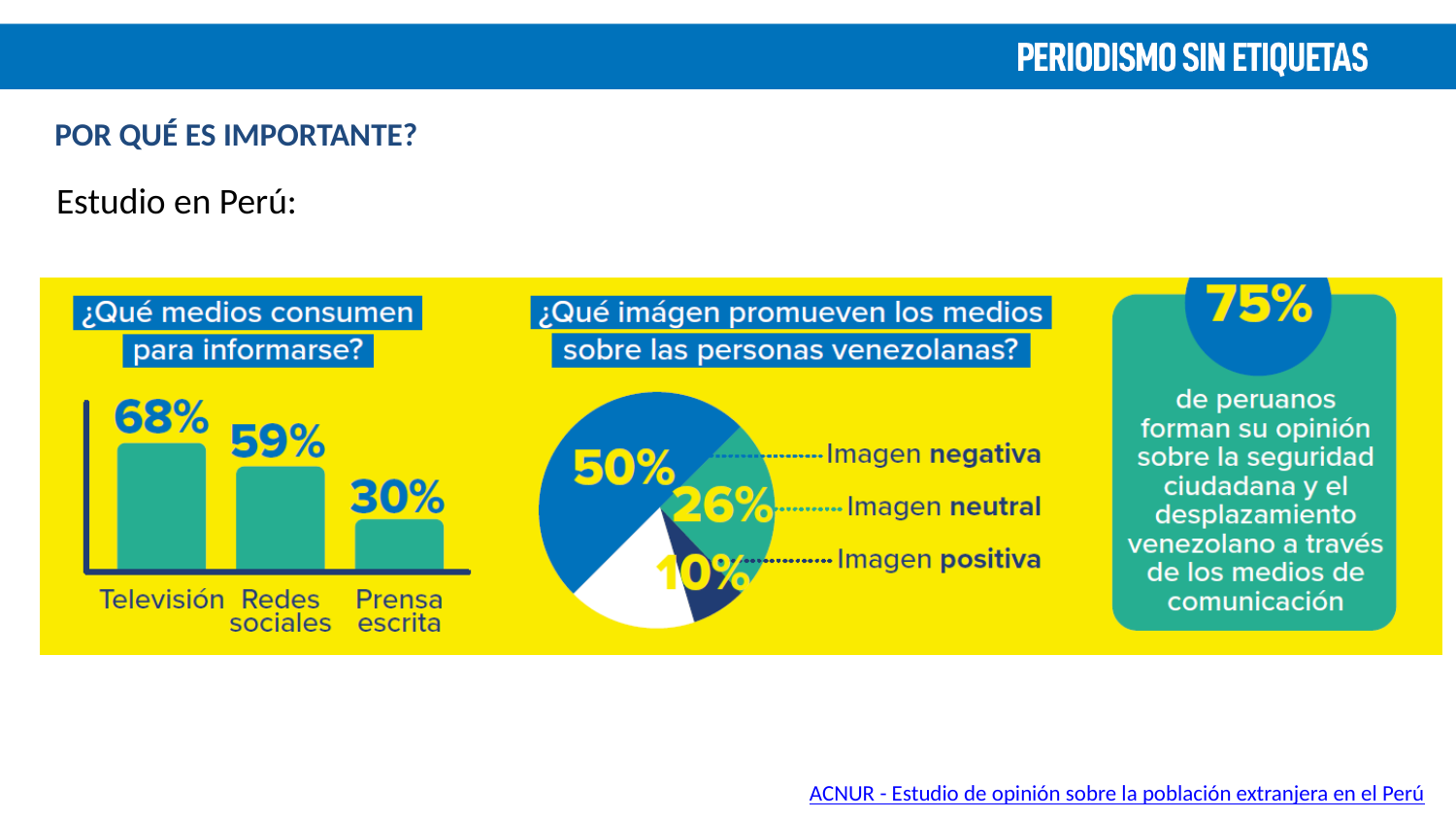
In the chart '¿Qué medios consumen para informarse?', what is the value for Televisión? 68% In the chart '¿Qué medios consumen para informarse?', which category has the highest value? Televisión In the chart '¿Qué imágen promueven los medios sobre las personas venezolanas?', what share is labelled Imagen negativa? 50% In the chart '¿Qué imágen promueven los medios sobre las personas venezolanas?', what share is labelled Imagen positiva? 10% In the chart '¿Qué medios consumen para informarse?', what is the value for Prensa escrita? 30% In the chart '¿Qué medios consumen para informarse?', which category has the lowest value? Prensa escrita In the chart '¿Qué medios consumen para informarse?', what is the value for Redes sociales? 59% In the chart '¿Qué medios consumen para informarse?', how many categories are shown? 3 What kind of chart is '¿Qué imágen promueven los medios sobre las personas venezolanas?'? Pie chart In the chart '¿Qué medios consumen para informarse?', what is the difference between the values for Televisión and Prensa escrita? 38% In the chart '¿Qué imágen promueven los medios sobre las personas venezolanas?', which is larger, Imagen neutral or Imagen positiva? Imagen neutral What kind of chart is '¿Qué medios consumen para informarse?'? Bar chart